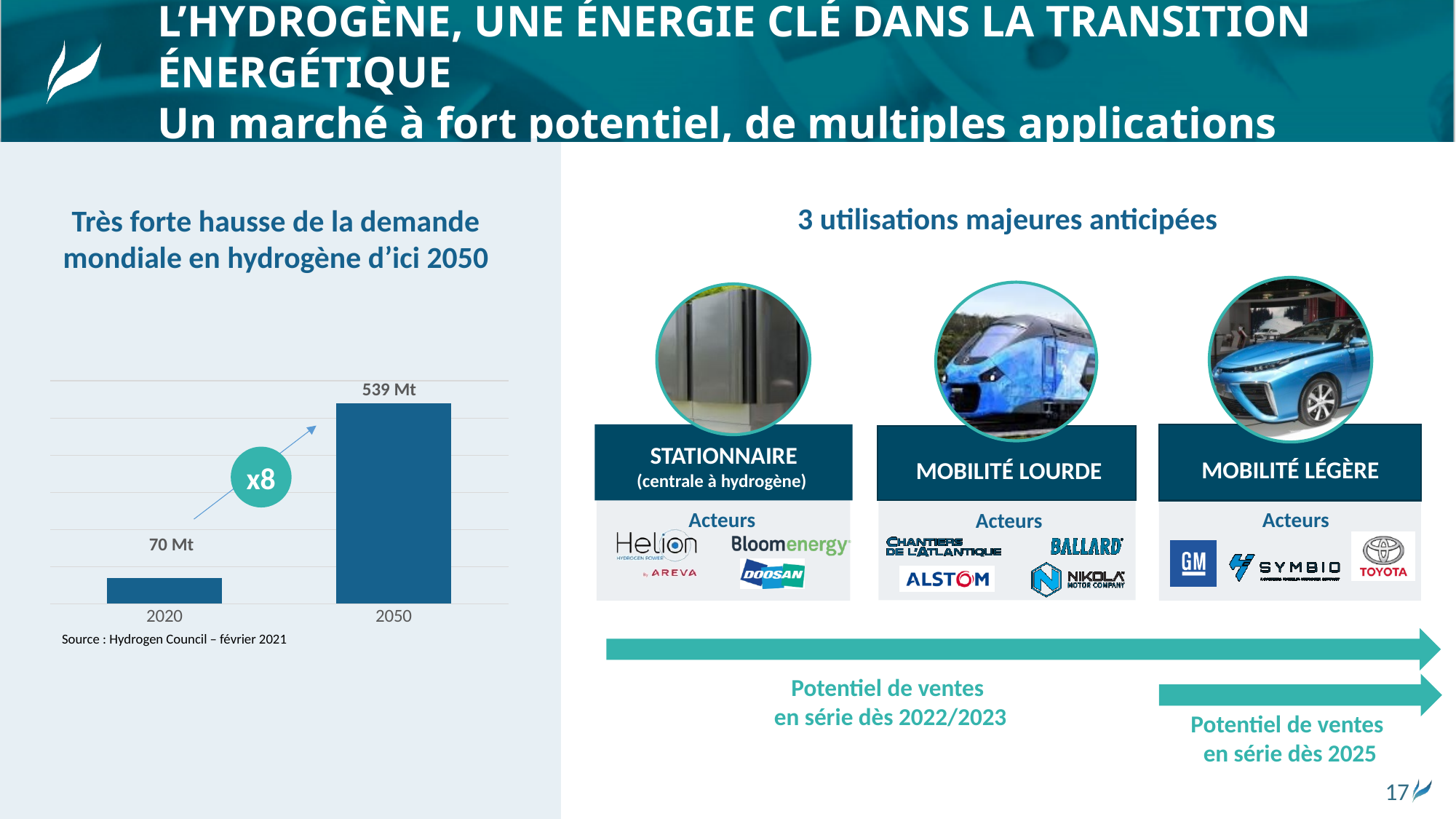
What is the difference between the 2050 and 2020 values in the hydrogen demand chart? 469 Mt Which year has the lower hydrogen demand value in the chart? 2020 How many bars are plotted in the hydrogen demand chart? 2 What is the value shown for 2020 in the hydrogen demand chart? 70 Mt Do the values in the hydrogen demand chart rise or fall from 2020 to 2050? rise What is the value shown for 2050 in the hydrogen demand chart? 539 Mt What kind of chart is used to show the hydrogen demand? bar chart What source is cited below the hydrogen demand chart? Hydrogen Council – février 2021 What multiplication factor is shown in the circle on the hydrogen demand chart? x8 Is the value for 2050 larger or smaller than the value for 2020 in the hydrogen demand chart? larger Which year has the higher hydrogen demand value in the chart? 2050